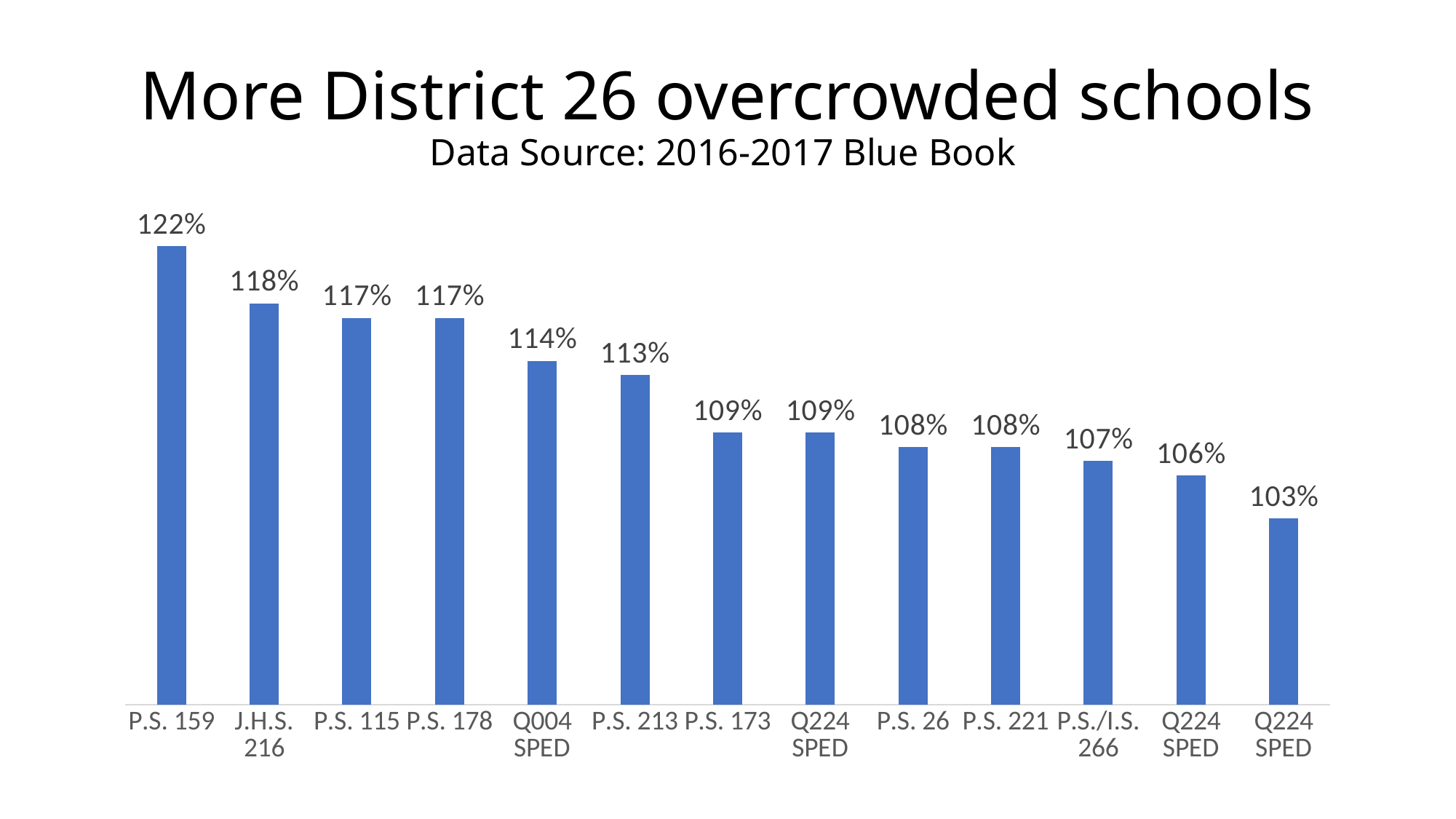
Which school has the highest value? P.S. 159 What is the value for P.S. 213? 113% What is the value for J.H.S. 216? 118% Do the values rise or fall from left to right across the chart? Fall What is the difference between the values for P.S. 159 and P.S. 26? 14% What kind of chart is shown on the slide? Bar chart What is the value for P.S./I.S. 266? 107% Which is larger, the value for Q004 SPED or the value for P.S. 173? Q004 SPED What is the value for P.S. 159? 122% What is the lowest value shown on the chart? 103% What data source is cited under the chart title? 2016-2017 Blue Book How many bars are shown on the chart? 13